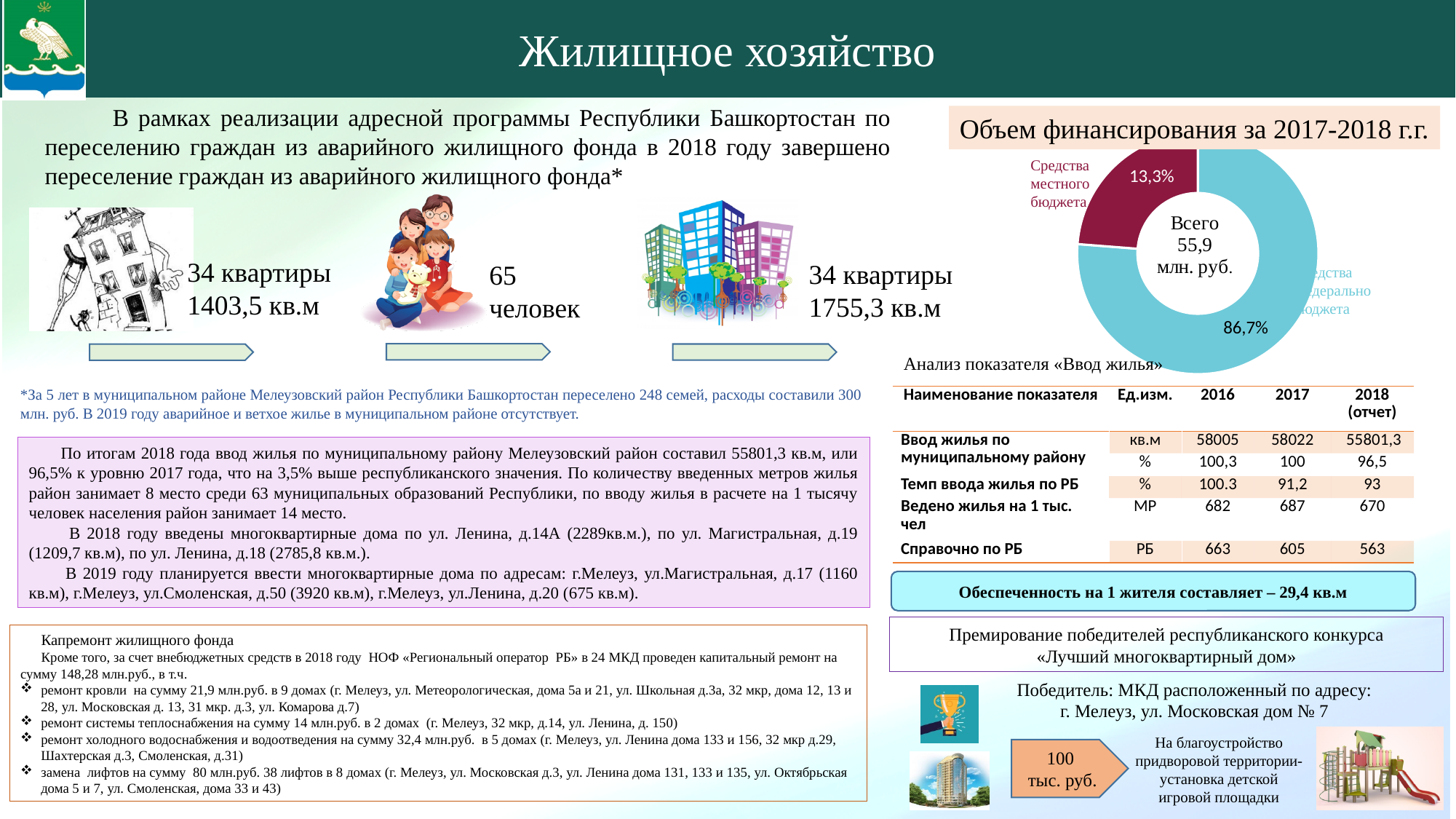
What total amount is shown in the centre of the pie chart? 55,9 млн. руб. What share does the larger (light blue) slice of the pie chart represent? 86,7% What is the title of the chart on the slide? Объем финансирования за 2017-2018 г.г. How many slices does the pie chart have? 2 What is the difference in percentage points between the larger slice (86,7%) and the «Средства местного бюджета» slice (13,3%)? 73,4 Is the share of «Средства местного бюджета» larger or smaller than the share of the other slice? smaller Which category has the smallest share in the pie chart? Средства местного бюджета What kind of chart is used to show «Объем финансирования за 2017-2018 г.г.»? pie chart (donut) What share of the financing comes from «Средства местного бюджета»? 13,3%